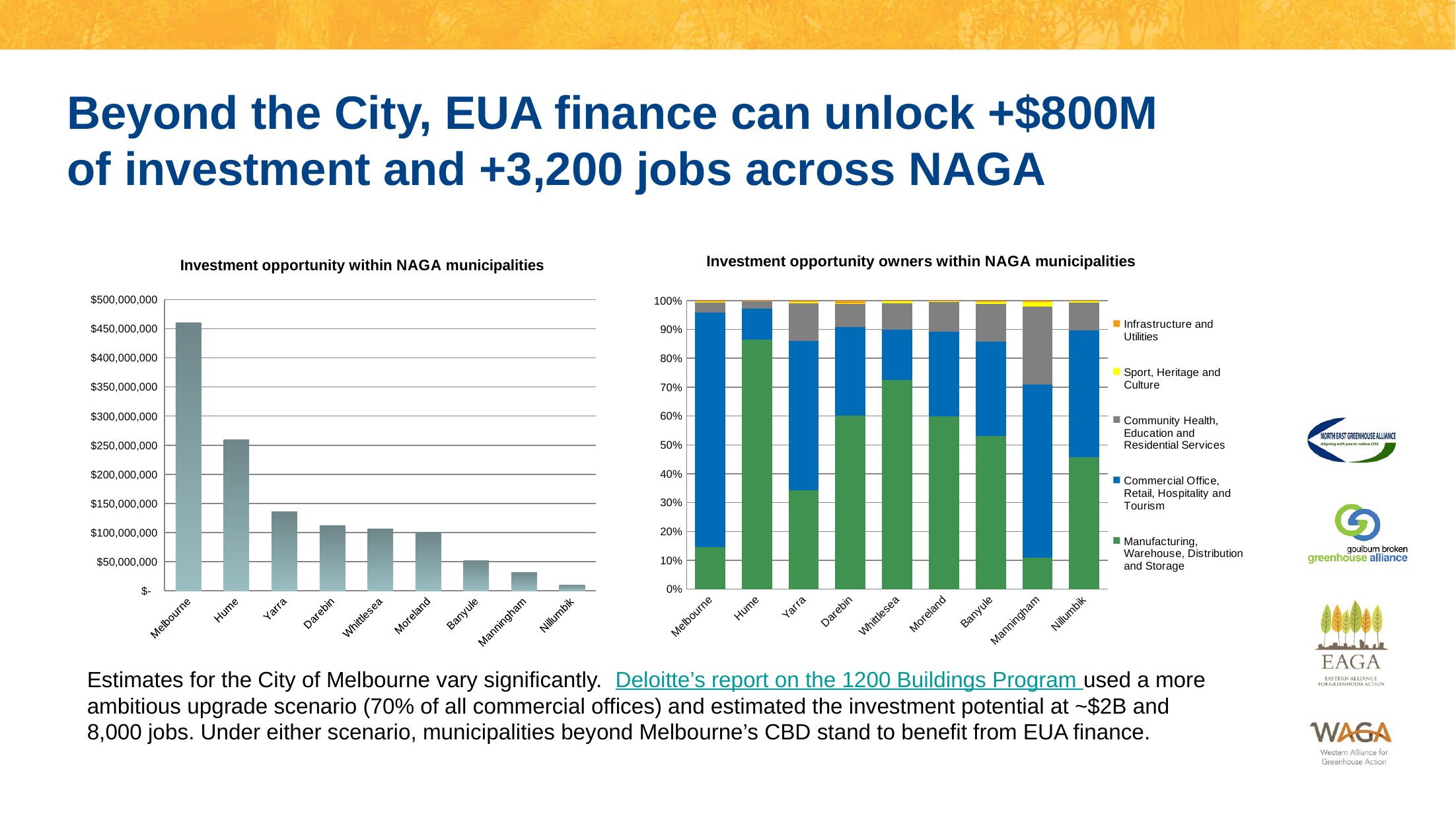
In the 'Investment opportunity within NAGA municipalities' chart, do the values rise or fall moving from left to right along the x axis? Fall In the 'Investment opportunity owners within NAGA municipalities' chart, which colour represents Commercial Office, Retail, Hospitality and Tourism? Blue In the 'Investment opportunity within NAGA municipalities' chart, is the value for Hume greater or less than $300,000,000? less In the 'Investment opportunity within NAGA municipalities' chart, which has a larger investment opportunity, Yarra or Manningham? Yarra How many series does the legend of the 'Investment opportunity owners within NAGA municipalities' chart list? 5 In the 'Investment opportunity within NAGA municipalities' chart, is the value for Melbourne greater or less than $400,000,000? greater What kind of chart is the 'Investment opportunity within NAGA municipalities' chart on the left? Bar chart In the 'Investment opportunity within NAGA municipalities' chart, how many municipalities are shown on the x axis? 9 In the 'Investment opportunity owners within NAGA municipalities' chart, which municipality has the largest share for Manufacturing, Warehouse, Distribution and Storage? Hume In the 'Investment opportunity within NAGA municipalities' chart, which municipality has the highest investment opportunity? Melbourne In the 'Investment opportunity within NAGA municipalities' chart, which municipality has the lowest investment opportunity? Nillumbik In the 'Investment opportunity within NAGA municipalities' chart, is the value for Banyule greater or less than $100,000,000? less